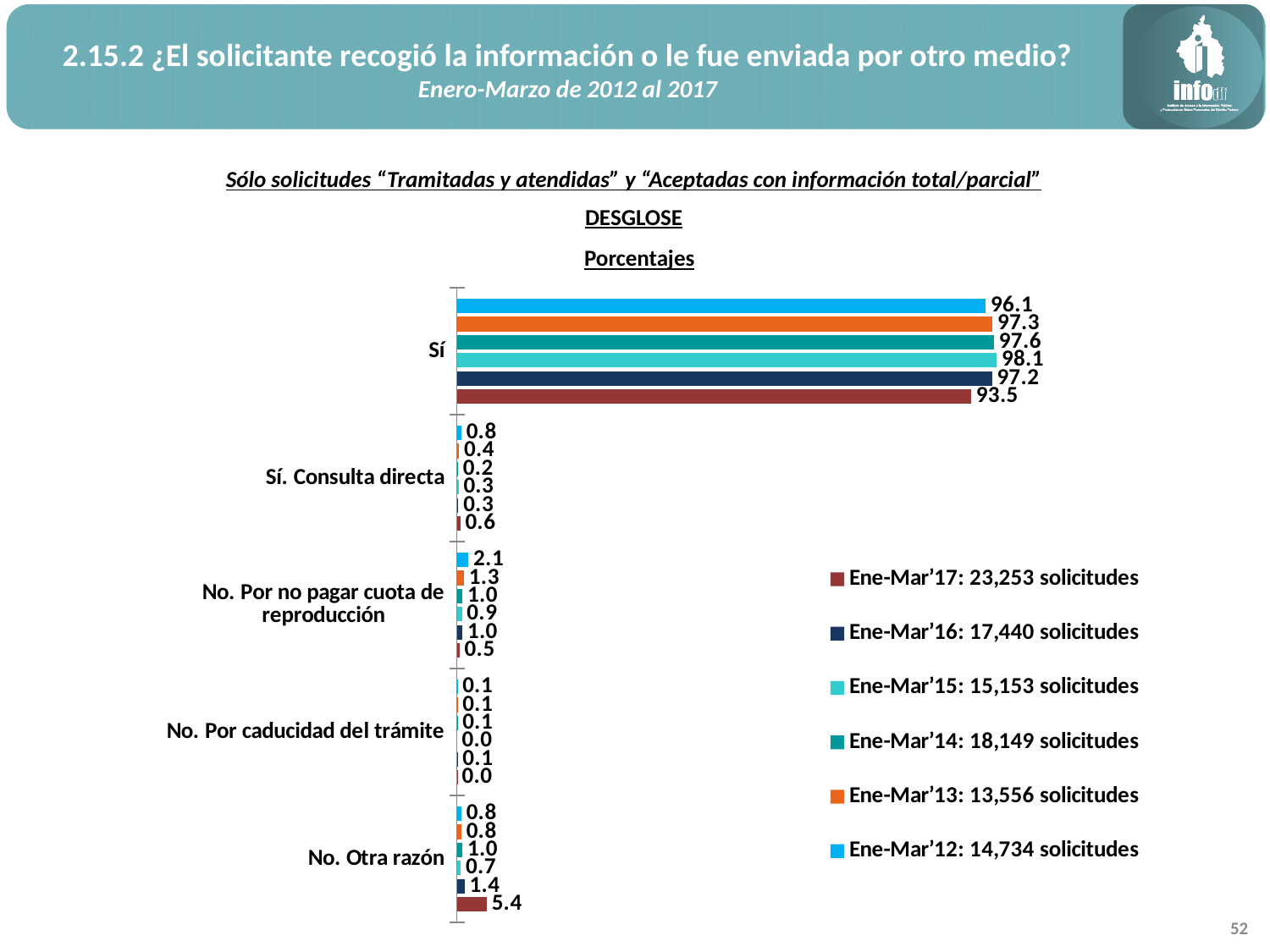
What is the value for "Sí" in the Ene-Mar'17 series? 93.5 According to the legend, how many solicitudes does the Ene-Mar'14 series represent? 18,149 solicitudes Which series has the highest value for "Sí"? Ene-Mar'15 How many series does the legend list? 6 How many categories are shown on the chart? 5 For "No. Otra razón", which is larger: the Ene-Mar'16 value or the Ene-Mar'17 value? Ene-Mar'17 Which series has the lowest value for "Sí"? Ene-Mar'17 What is the difference between the Ene-Mar'15 and Ene-Mar'17 values for "Sí"? 4.6 What is the value for "No. Por no pagar cuota de reproducción" in the Ene-Mar'12 series? 2.1 What kind of chart is shown on the slide? Bar chart What is the value for "No. Otra razón" in the Ene-Mar'17 series? 5.4 What is the value for "Sí" in the Ene-Mar'15 series? 98.1